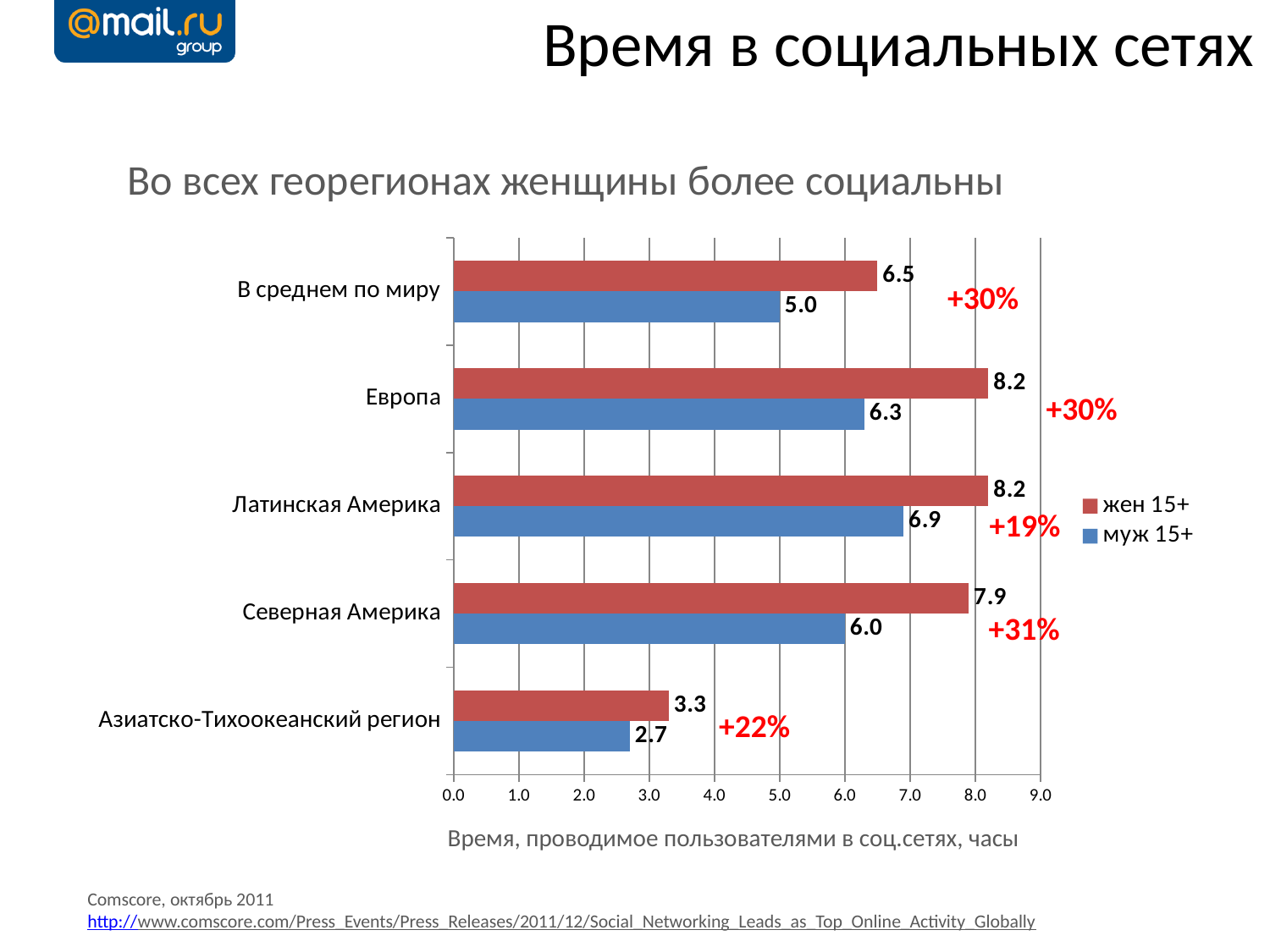
What is the value for "жен 15+" in Европа? 8.2 What is the value for "муж 15+" in Северная Америка? 6.0 What is the value for "муж 15+" for В среднем по миру? 5.0 How many regions (categories) are shown on the chart? 5 What percentage annotation is shown next to the bars for Северная Америка? +31% What kind of chart is shown on the slide? Bar chart Which region has the highest value for "муж 15+"? Латинская Америка Which region has the lowest value for "жен 15+"? Азиатско-Тихоокеанский регион How many series does the legend list? 2 What is the x-axis label of the chart? Время, проводимое пользователями в соц.сетях, часы Which is larger in Азиатско-Тихоокеанский регион: the value for "жен 15+" or for "муж 15+"? жен 15+ What is the difference between the "жен 15+" and "муж 15+" values in Латинская Америка? 1.3